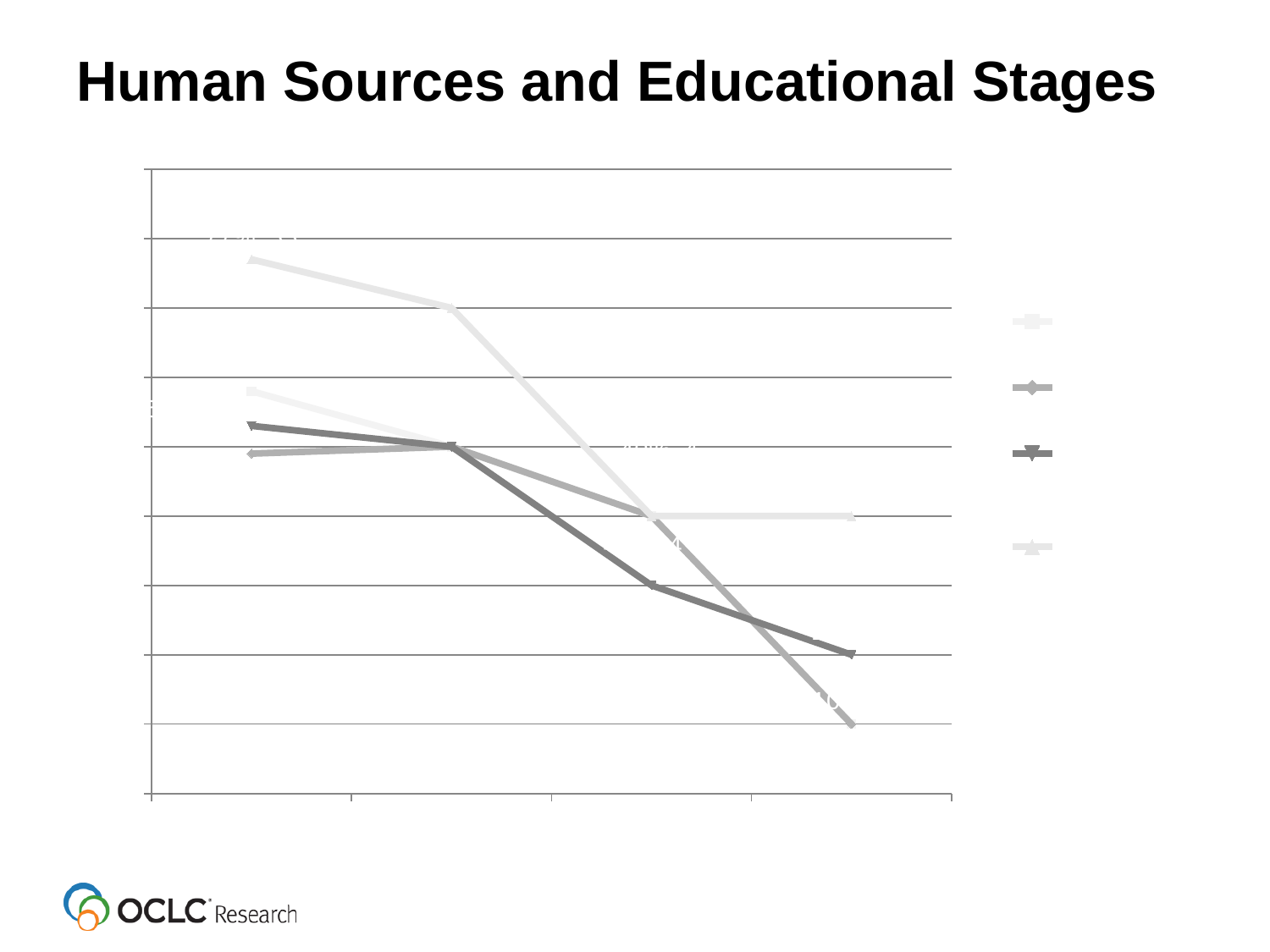
What kind of chart is shown on the slide? line chart How many data points does each line have along the x axis? 4 How many series does the legend list? 4 Does the topmost line at the left of the chart rise or fall from its first point to its last point? fall What is the title of the slide's chart? Human Sources and Educational Stages How many lines are plotted on the chart? 4 Overall, do the plotted values rise or fall from left to right along the x axis? fall